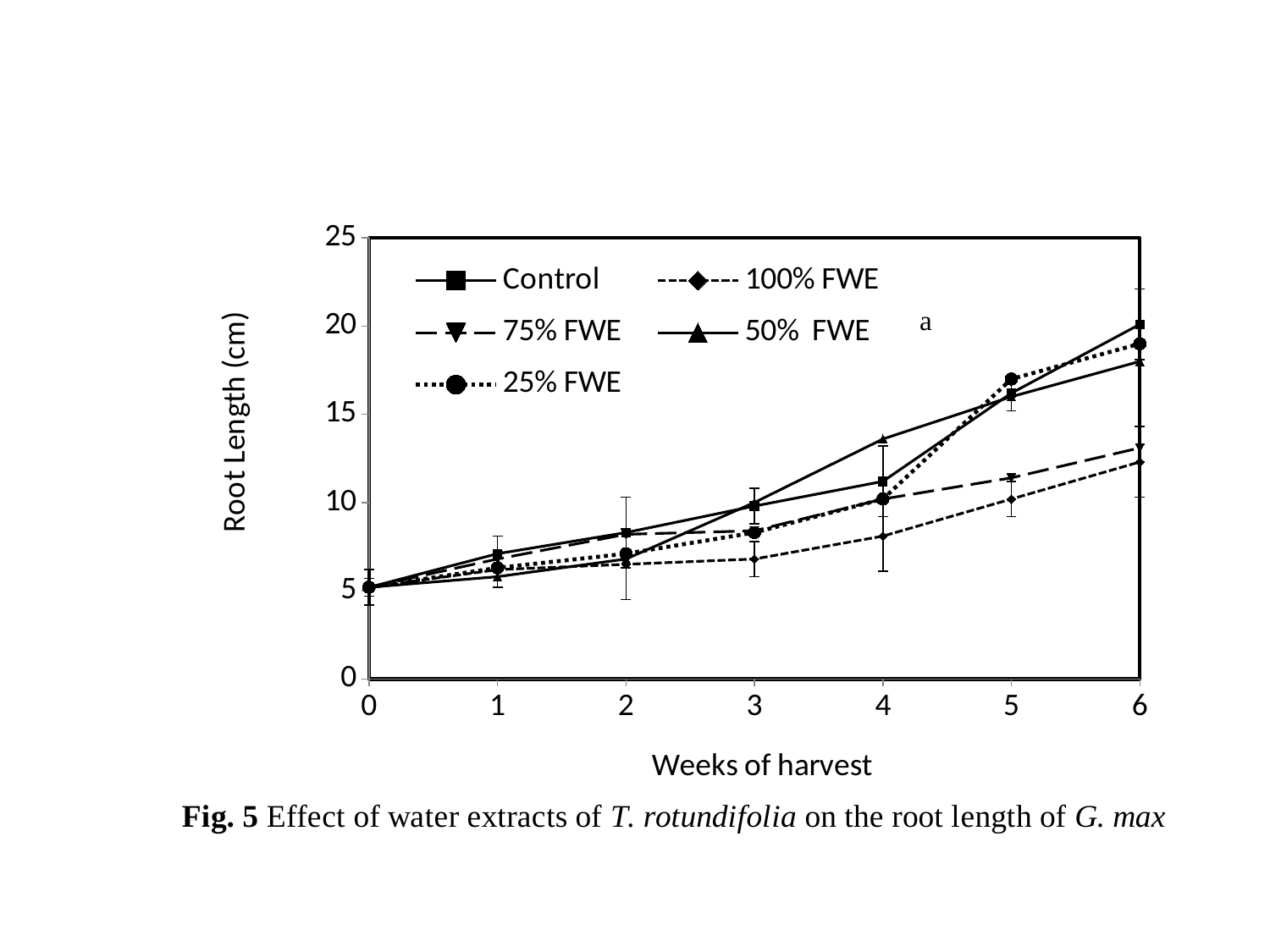
What is the label of the y axis? Root Length (cm) Is the root length for Control at week 6 greater or less than 15? greater What kind of chart is shown on the slide? line chart At week 6, which has the larger root length, Control or 100% FWE? Control Does the root length for Control rise or fall across the weeks of harvest? rise Is the root length for 100% FWE at week 3 greater or less than 10? less What is the label of the x axis? Weeks of harvest At week 4, which has the larger root length, 50% FWE or 100% FWE? 50% FWE Is the root length for 50% FWE at week 4 greater or less than 10? greater How many series does the legend list? 5 How many weeks of harvest are plotted along the x axis? 7